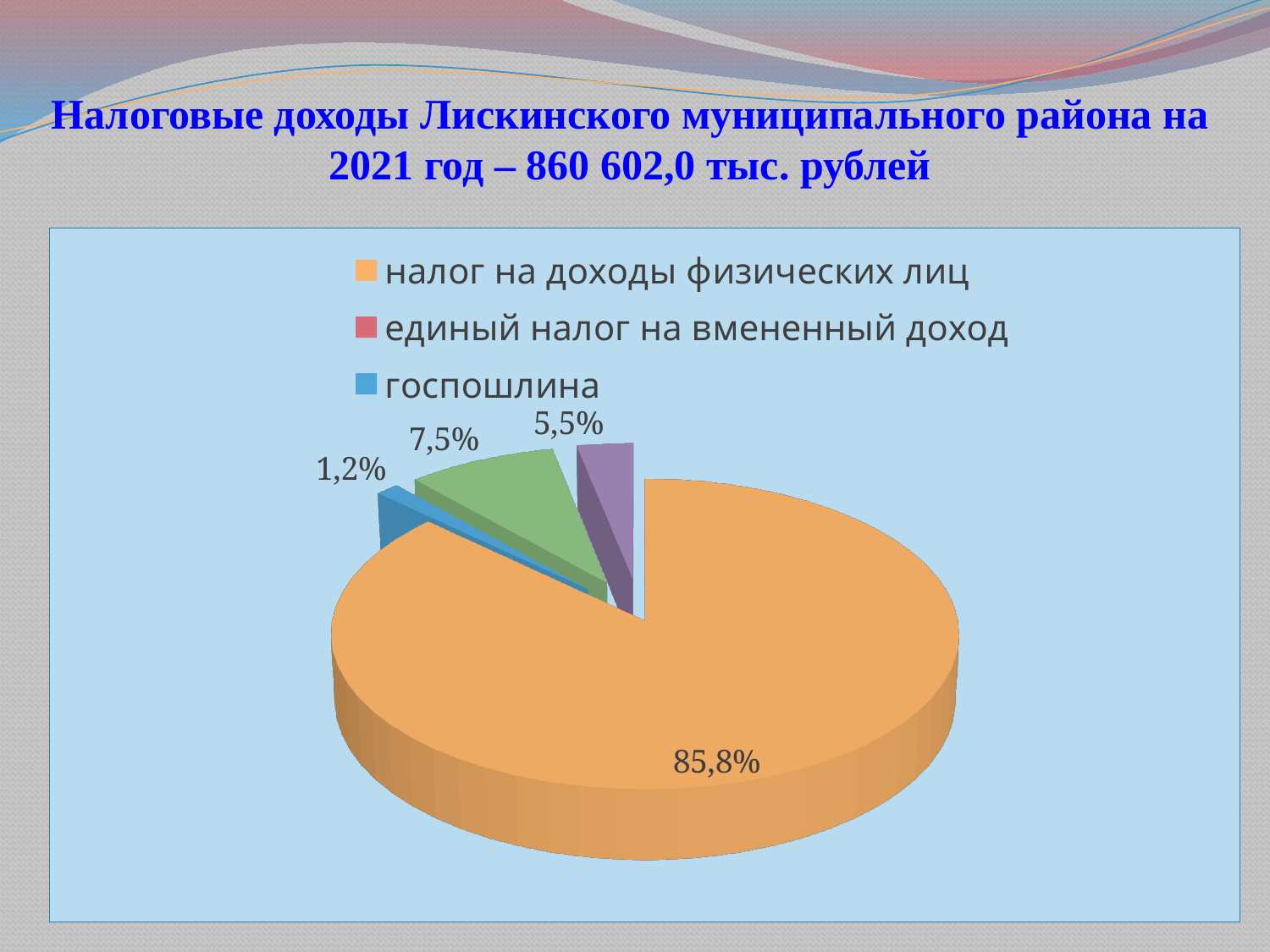
What share of tax revenues does "налог на доходы физических лиц" account for? 85,8% By how many percentage points does the "налог на доходы физических лиц" slice exceed the "госпошлина" slice? 84,6% What total amount of tax revenues for 2021 is stated in the slide title? 860 602,0 тыс. рублей What is the second-largest percentage label shown on the pie chart? 7,5% Which category has the smallest slice of the pie? госпошлина What share of tax revenues does "госпошлина" account for? 1,2% Which is larger: the slice for "налог на доходы физических лиц" or the slice for "госпошлина"? налог на доходы физических лиц What kind of chart is shown on the slide? pie chart How many entries does the legend list? 3 How many slices does the pie chart have? 4 Which category has the largest slice of the pie? налог на доходы физических лиц What colour is the slice for "налог на доходы физических лиц"? orange